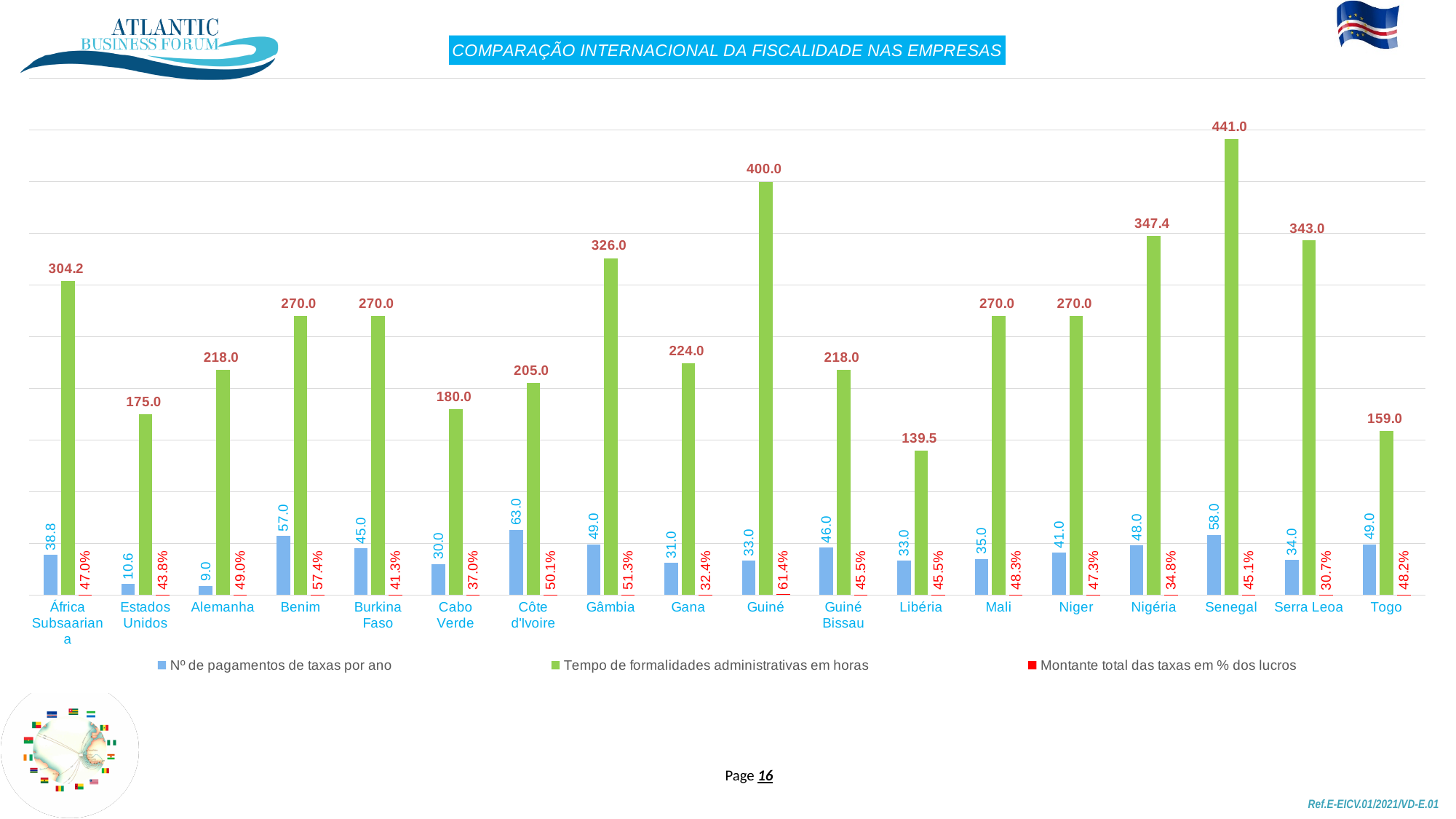
Which country has the lowest value for 'Montante total das taxas em % dos lucros'? Serra Leoa What type of chart is shown on the slide? Bar chart How many series does the chart legend list? 3 What is the difference in 'Tempo de formalidades administrativas em horas' between Senegal and Cabo Verde? 261.0 What is the value of 'Nº de pagamentos de taxas por ano' for Côte d'Ivoire? 63.0 How many countries or regions are shown on the x axis of the chart? 18 Which country has the lowest value for 'Tempo de formalidades administrativas em horas'? Libéria Which country has the highest value for 'Tempo de formalidades administrativas em horas'? Senegal What is the value of 'Tempo de formalidades administrativas em horas' for Cabo Verde? 180.0 Which country has the lowest value for 'Nº de pagamentos de taxas por ano'? Alemanha What is the value of 'Montante total das taxas em % dos lucros' for Guiné? 61.4% Which has a higher value for 'Tempo de formalidades administrativas em horas', Gâmbia or Nigéria? Nigéria